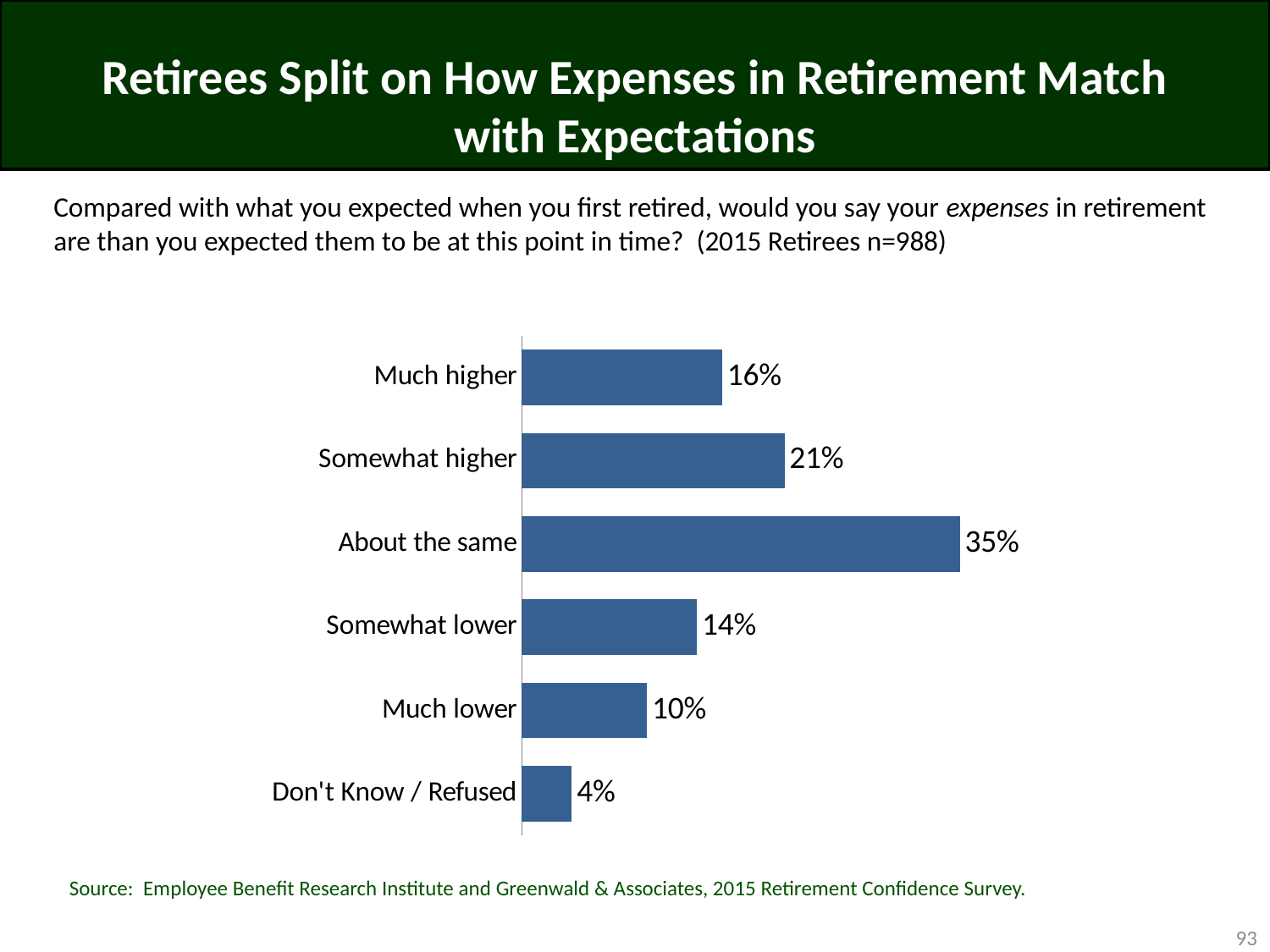
What is the value for 'Much lower'? 10% What percentage of respondents answered 'Don't Know / Refused'? 4% What type of chart is shown on the slide? Bar chart Which is larger, the value for 'Somewhat lower' or the value for 'Much higher'? Much higher What percentage of retirees said their expenses in retirement are much higher than expected? 16% How many response categories are shown in the chart? 6 What is the sample size of 2015 retirees stated on the slide? n=988 What is the difference in percentage points between 'About the same' and 'Somewhat higher'? 14 Which response category has the highest percentage? About the same What percentage of retirees said their expenses are about the same as expected? 35% Which response category has the lowest percentage? Don't Know / Refused What is the value for 'Somewhat higher'? 21%